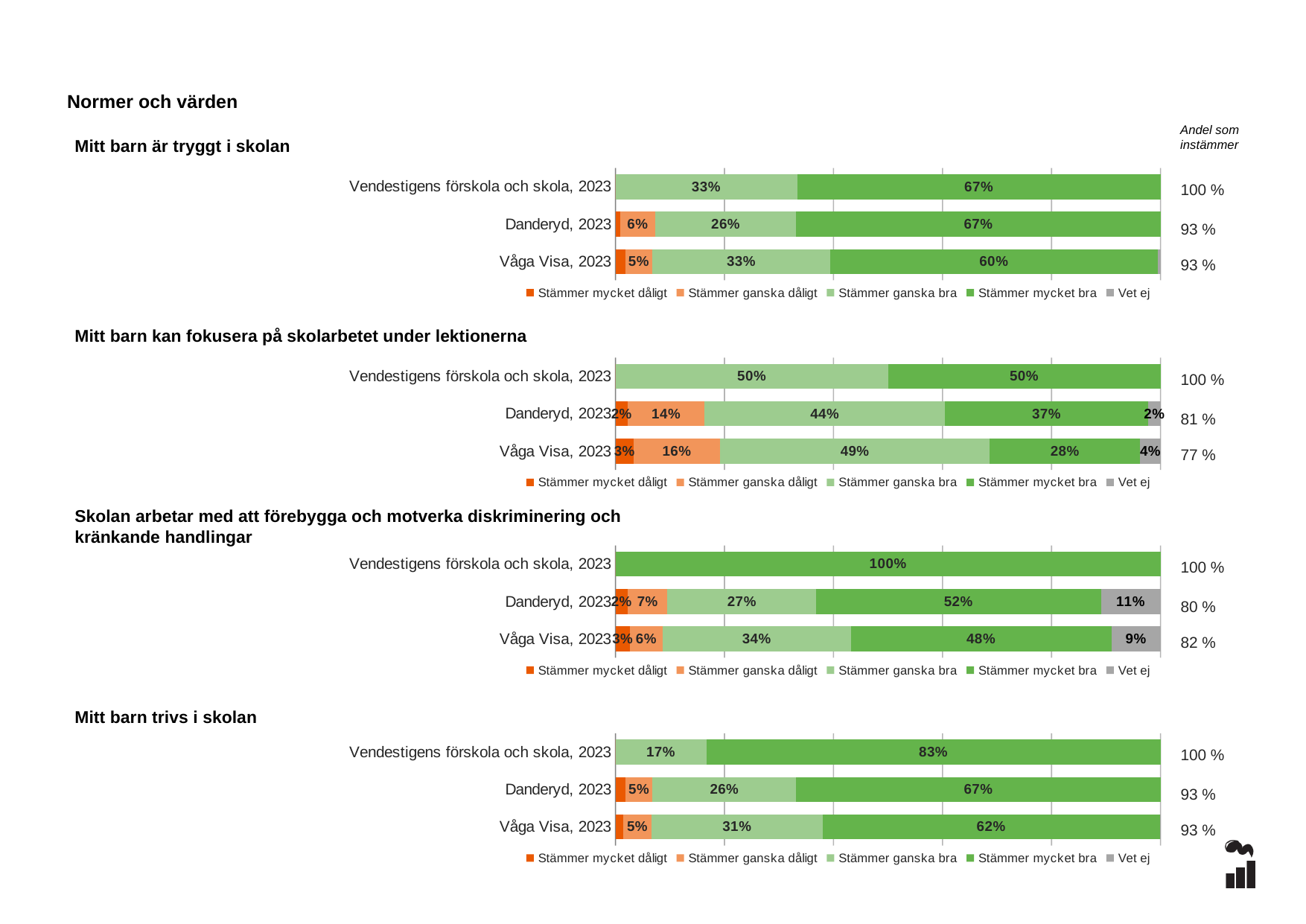
In the chart 'Mitt barn är tryggt i skolan', what is the 'Andel som instämmer' value for Danderyd, 2023? 93 % What kind of chart is 'Mitt barn kan fokusera på skolarbetet under lektionerna'? Stacked bar chart How many series does the legend list for the chart 'Mitt barn trivs i skolan'? 5 In the chart 'Mitt barn kan fokusera på skolarbetet under lektionerna', which row has the lowest 'Andel som instämmer'? Våga Visa, 2023 In the chart 'Skolan arbetar med att förebygga och motverka diskriminering och kränkande handlingar', what percentage for Danderyd, 2023 answered 'Vet ej'? 11% How many rows (categories) are shown in the chart 'Mitt barn är tryggt i skolan'? 3 What is the main heading at the top of the slide? Normer och värden In the chart 'Mitt barn är tryggt i skolan', what percentage of respondents for Vendestigens förskola och skola, 2023 answered 'Stämmer mycket bra'? 67% In the chart 'Mitt barn kan fokusera på skolarbetet under lektionerna', what percentage for Våga Visa, 2023 answered 'Stämmer ganska bra'? 49% In the chart 'Mitt barn trivs i skolan', what percentage for Vendestigens förskola och skola, 2023 answered 'Stämmer mycket bra'? 83% In the chart 'Mitt barn trivs i skolan', which is larger: the 'Stämmer mycket bra' share for Danderyd, 2023 or for Våga Visa, 2023? Danderyd, 2023 In the chart 'Skolan arbetar med att förebygga och motverka diskriminering och kränkande handlingar', what is the difference between the 'Stämmer mycket bra' shares for Danderyd, 2023 and Våga Visa, 2023? 4 percentage points